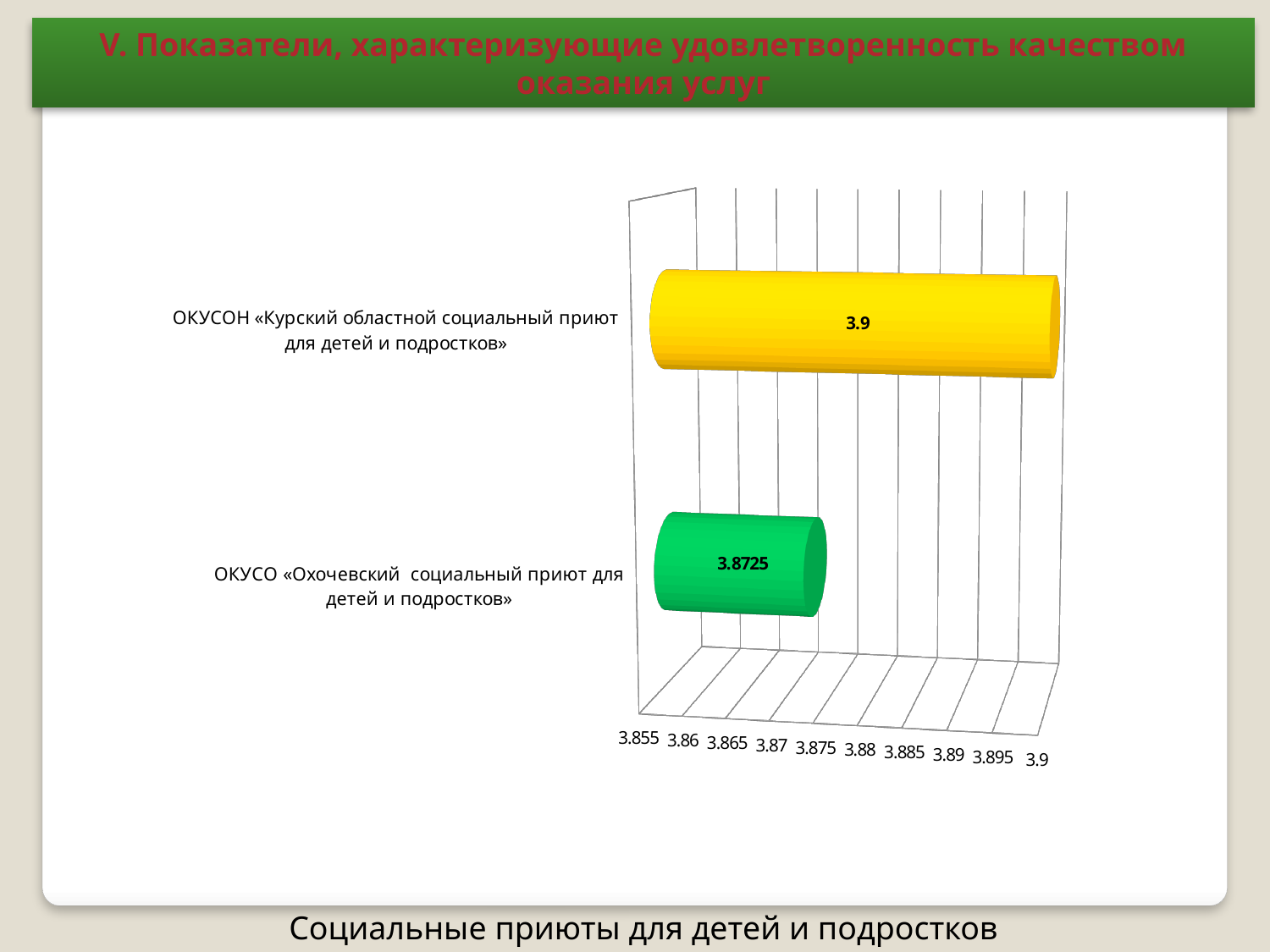
What kind of chart is shown on the slide? Bar chart Which category has the highest value? ОКУСОН «Курский областной социальный приют для детей и подростков» Which category has the lowest value? ОКУСО «Охочевский социальный приют для детей и подростков» What is the lowest value shown on the chart's value axis? 3.855 Which is larger: the value for ОКУСОН «Курский областной социальный приют для детей и подростков» or for ОКУСО «Охочевский социальный приют для детей и подростков»? ОКУСОН «Курский областной социальный приют для детей и подростков» Is the value for ОКУСО «Охочевский социальный приют для детей и подростков» greater or less than 3.88? less What value is shown for ОКУСОН «Курский областной социальный приют для детей и подростков»? 3.9 What colour is the bar for ОКУСО «Охочевский социальный приют для детей и подростков»? Green How many categories are shown in the chart? 2 What value is shown for ОКУСО «Охочевский социальный приют для детей и подростков»? 3.8725 Is the value for ОКУСОН «Курский областной социальный приют для детей и подростков» greater or less than 3.89? greater What is the difference between the values for ОКУСОН «Курский областной социальный приют для детей и подростков» and ОКУСО «Охочевский социальный приют для детей и подростков»? 0.0275